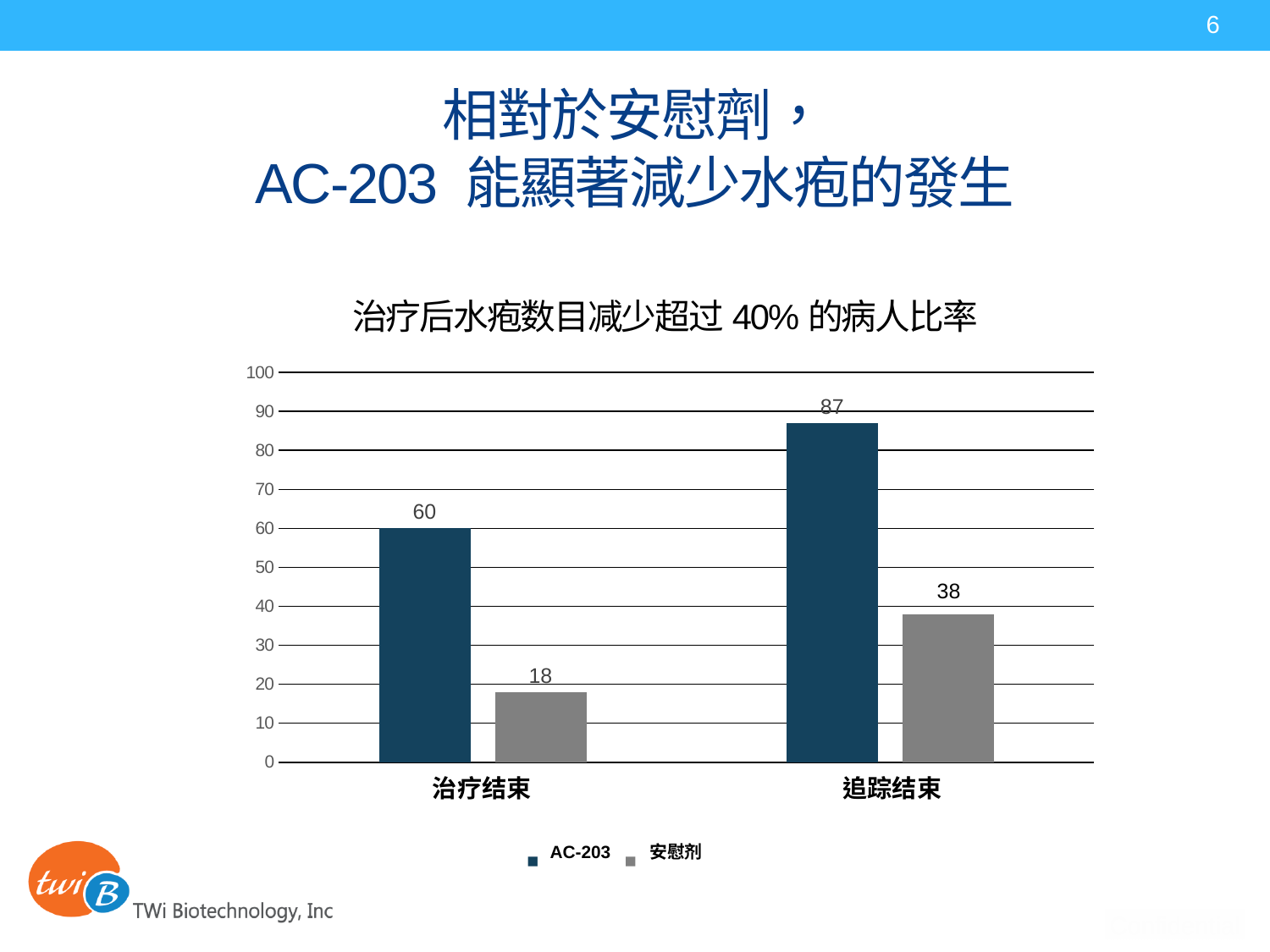
Which bar has the highest value in the chart? AC-203 at 追踪结束 What is the difference between AC-203 and 安慰剂 at 追踪结束? 49 How many categories are shown on the x axis? 2 What is the value for AC-203 at 追踪结束? 87 What is the difference between AC-203 and 安慰剂 at 治疗结束? 42 Which is larger at 治疗结束, AC-203 or 安慰剂? AC-203 Which bar has the lowest value in the chart? 安慰剂 at 治疗结束 What kind of chart is shown on the slide? Bar chart How many series does the legend list? 2 What is the value for 安慰剂 at 治疗结束? 18 What is the value for 安慰剂 at 追踪结束? 38 What is the value for AC-203 at 治疗结束? 60